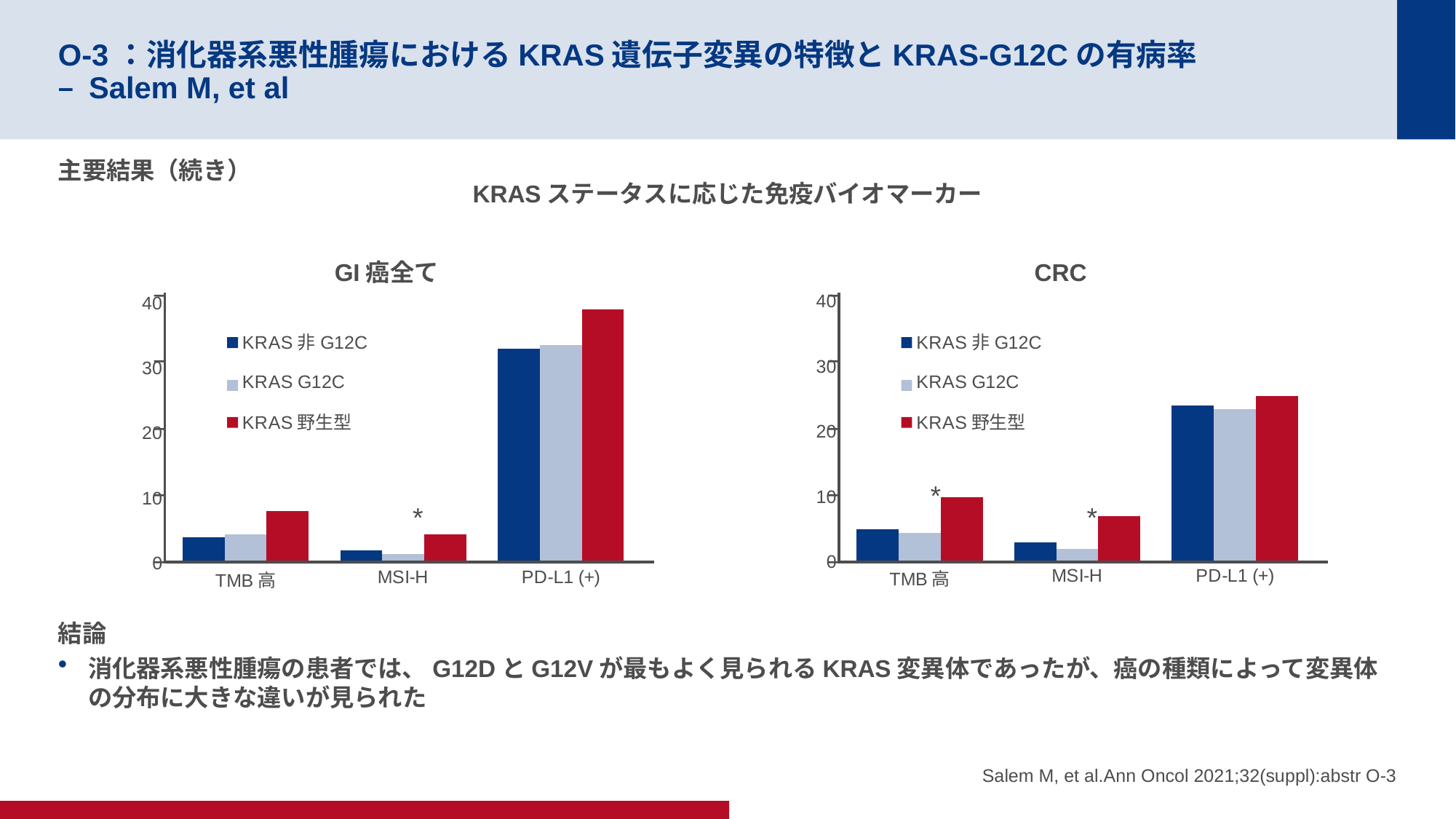
In the "GI 癌全て" chart, which is larger for MSI-H: KRAS 野生型 or KRAS G12C? KRAS 野生型 How many series does the legend of the "CRC" chart list? 3 In the "CRC" chart, is the KRAS 野生型 value for MSI-H greater or less than 10? less In the "CRC" chart, which is larger for TMB 高: KRAS 野生型 or KRAS 非 G12C? KRAS 野生型 In the "CRC" chart, is the KRAS 非 G12C value for PD-L1 (+) greater or less than 30? less How many categories are shown on the x axis of the "GI 癌全て" chart? 3 In the "GI 癌全て" chart, is the KRAS 野生型 value for PD-L1 (+) greater or less than 30? greater In the "GI 癌全て" chart, which series is shown in red? KRAS 野生型 What kind of chart is the "GI 癌全て" chart? bar chart In the "CRC" chart, which category has the lowest value for KRAS G12C? MSI-H In the "GI 癌全て" chart, which category has the highest value for KRAS 野生型? PD-L1 (+) What is the overall title shown above the two charts? KRAS ステータスに応じた免疫バイオマーカー